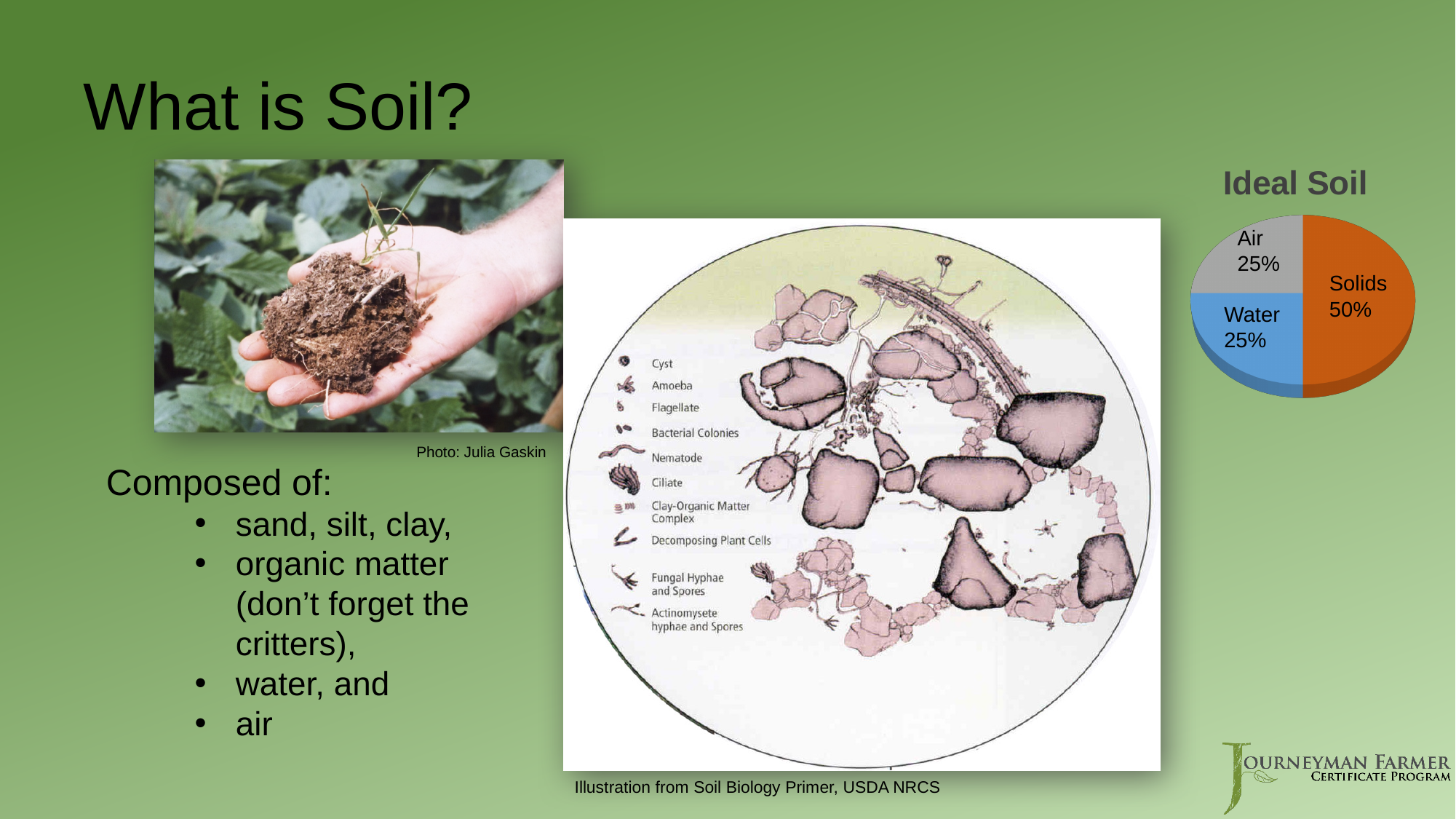
In the 'Ideal Soil' pie chart, what share is Water? 25% In the 'Ideal Soil' pie chart, what is the difference between the Solids share and the Water share? 25% In the 'Ideal Soil' pie chart, what share is Air? 25% Which slice of the 'Ideal Soil' pie chart is the largest? Solids In the 'Ideal Soil' pie chart, what share is Solids? 50% In the 'Ideal Soil' pie chart, which is larger, Solids or Air? Solids What is the title of the pie chart on the slide? Ideal Soil In the 'Ideal Soil' pie chart, what is the combined share of Water and Air? 50% In the 'Ideal Soil' pie chart, what colour is the Solids slice? orange How many slices does the 'Ideal Soil' pie chart have? 3 What kind of chart is the 'Ideal Soil' chart? pie chart